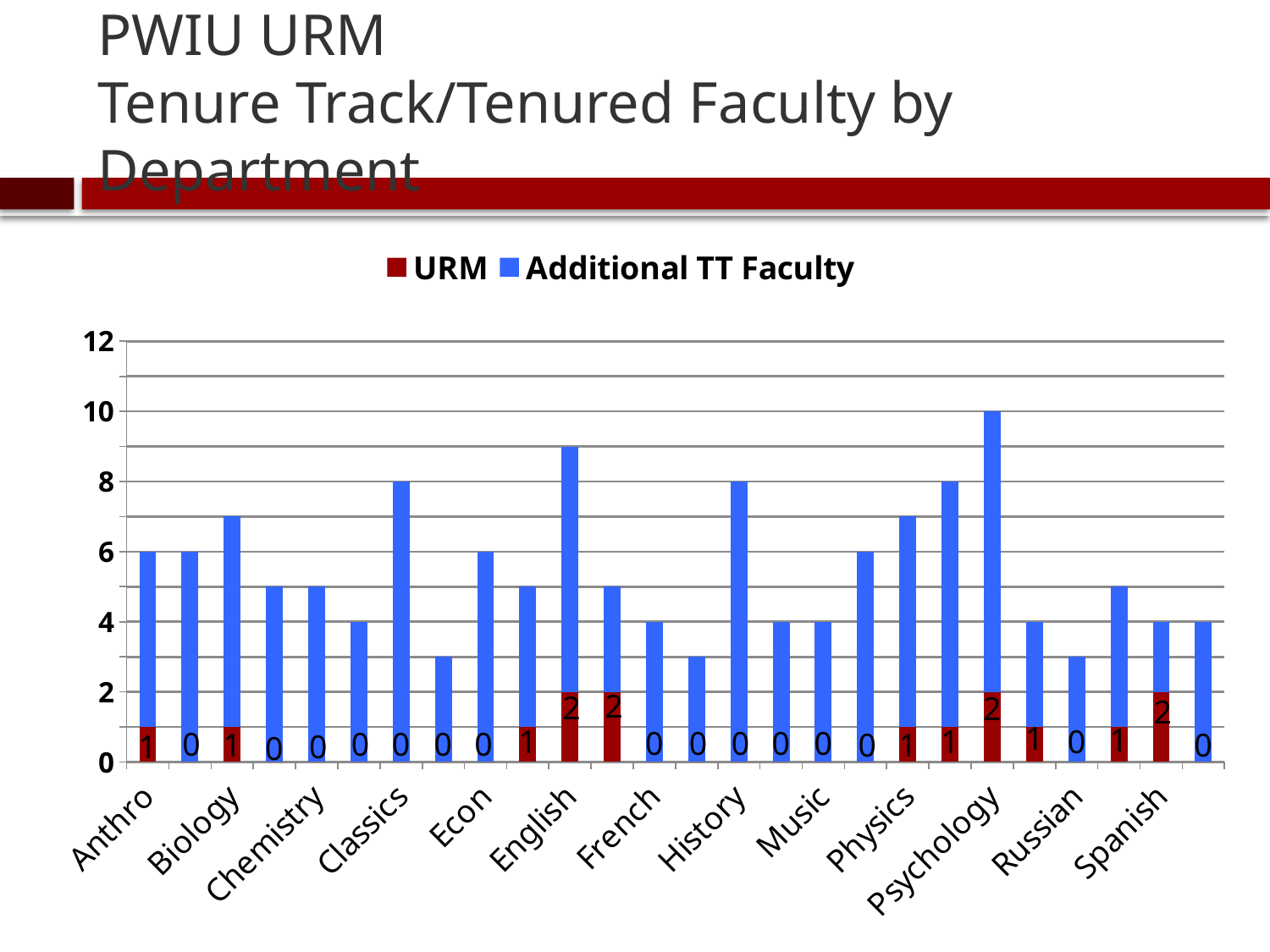
What is the URM value for Classics? 0 What is the total height of the Psychology bar? 10 What is the URM value for Anthro? 1 Which has a taller total bar, English or French? English What is the URM value for English? 2 What is the URM value for Psychology? 2 How many series does the legend list? 2 What kind of chart is shown on the slide? bar chart Which labeled department has the tallest total bar? Psychology Is the total bar for Russian greater or less than 4? less Is the total bar for Classics greater or less than 6? greater What colour represents the URM series in the legend? dark red